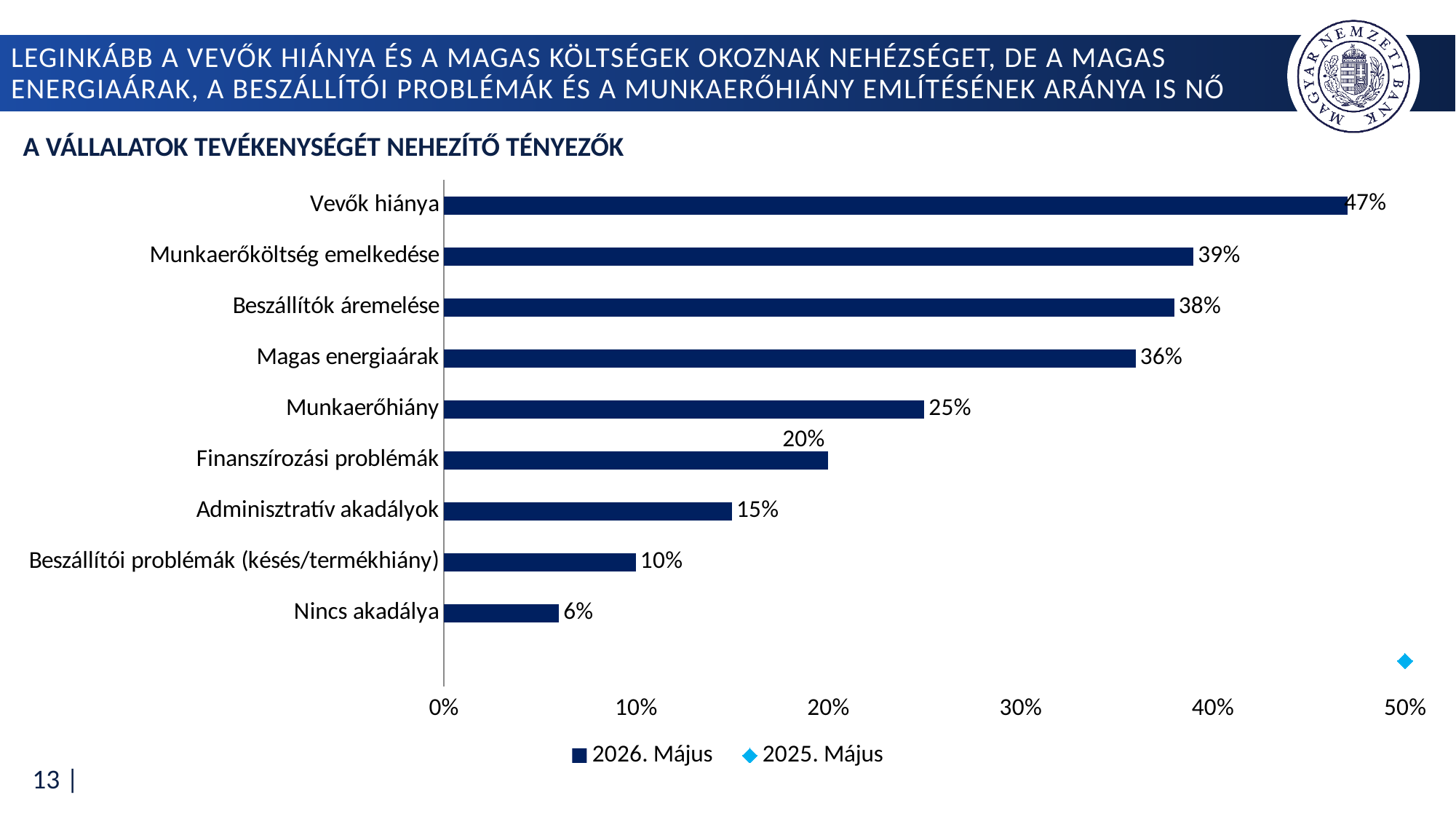
What is the title of the chart? A VÁLLALATOK TEVÉKENYSÉGÉT NEHEZÍTŐ TÉNYEZŐK What is the value for Vevők hiánya? 47% How many series does the legend list? 2 What is the difference between the values for Vevők hiánya and Munkaerőköltség emelkedése? 8% Which category has the lowest value? Nincs akadálya What is the value for Nincs akadálya? 6% What kind of chart is shown on the slide? Bar chart What is the value for Munkaerőhiány? 25% How many categories are shown on the chart? 9 Which is larger, the value for Magas energiaárak or the value for Munkaerőhiány? Magas energiaárak What is the value for Beszállítói problémák (késés/termékhiány)? 10% Which category has the highest value? Vevők hiánya